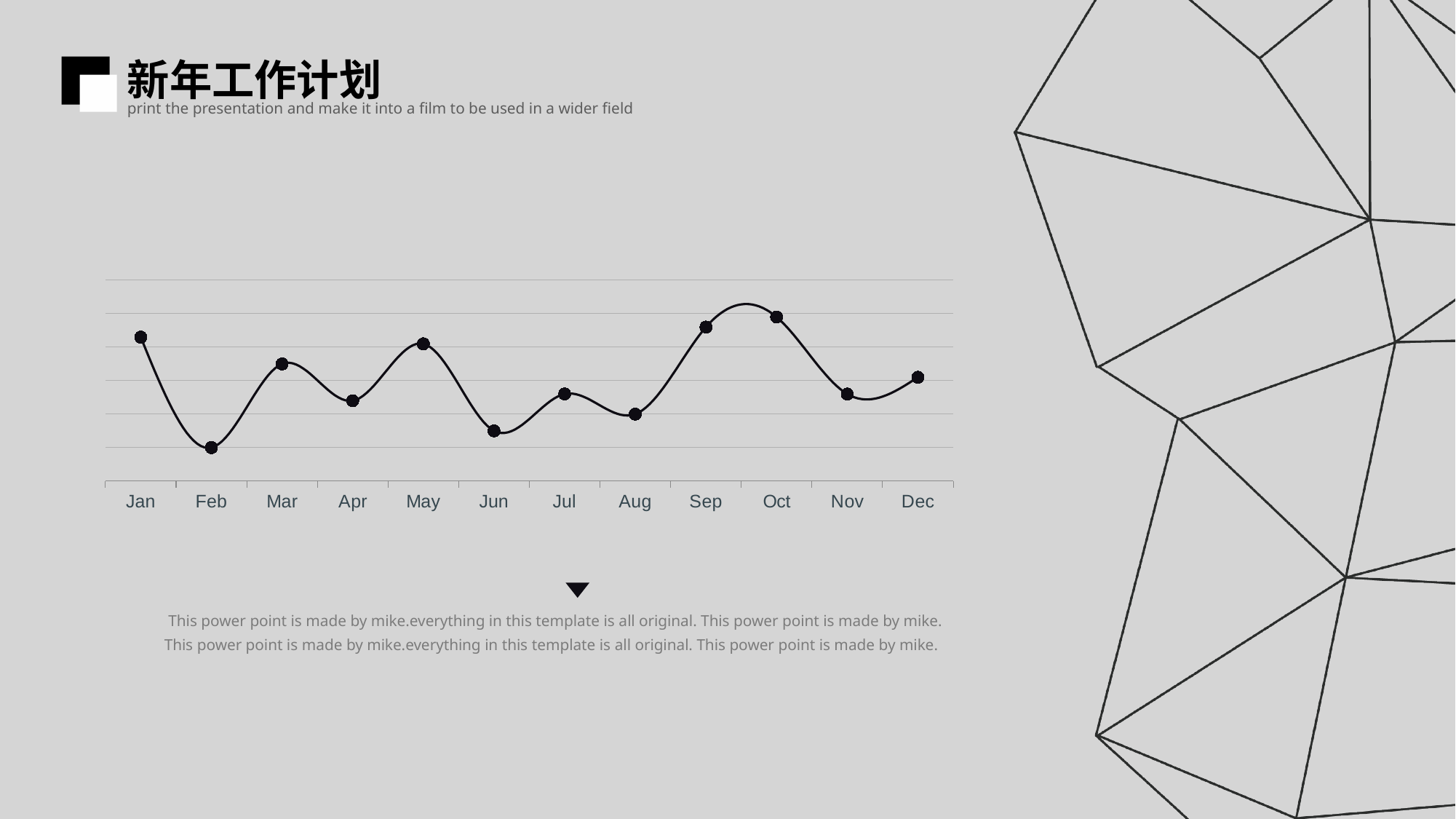
Which is larger, the value for Mar or the value for Apr? Mar What is the first category label on the x axis of the chart? Jan How many months are plotted along the x axis of the chart? 12 Does the line rise or fall from Jan to Feb? fall What kind of chart is shown on the slide? line chart Does the line rise or fall from Aug to Oct? rise Which month has the lowest value in the chart? Feb Which is larger, the value for May or the value for Jun? May Does the line rise or fall from Oct to Nov? fall Which is larger, the value for Jan or the value for Feb? Jan Which month has the highest value in the chart? Oct